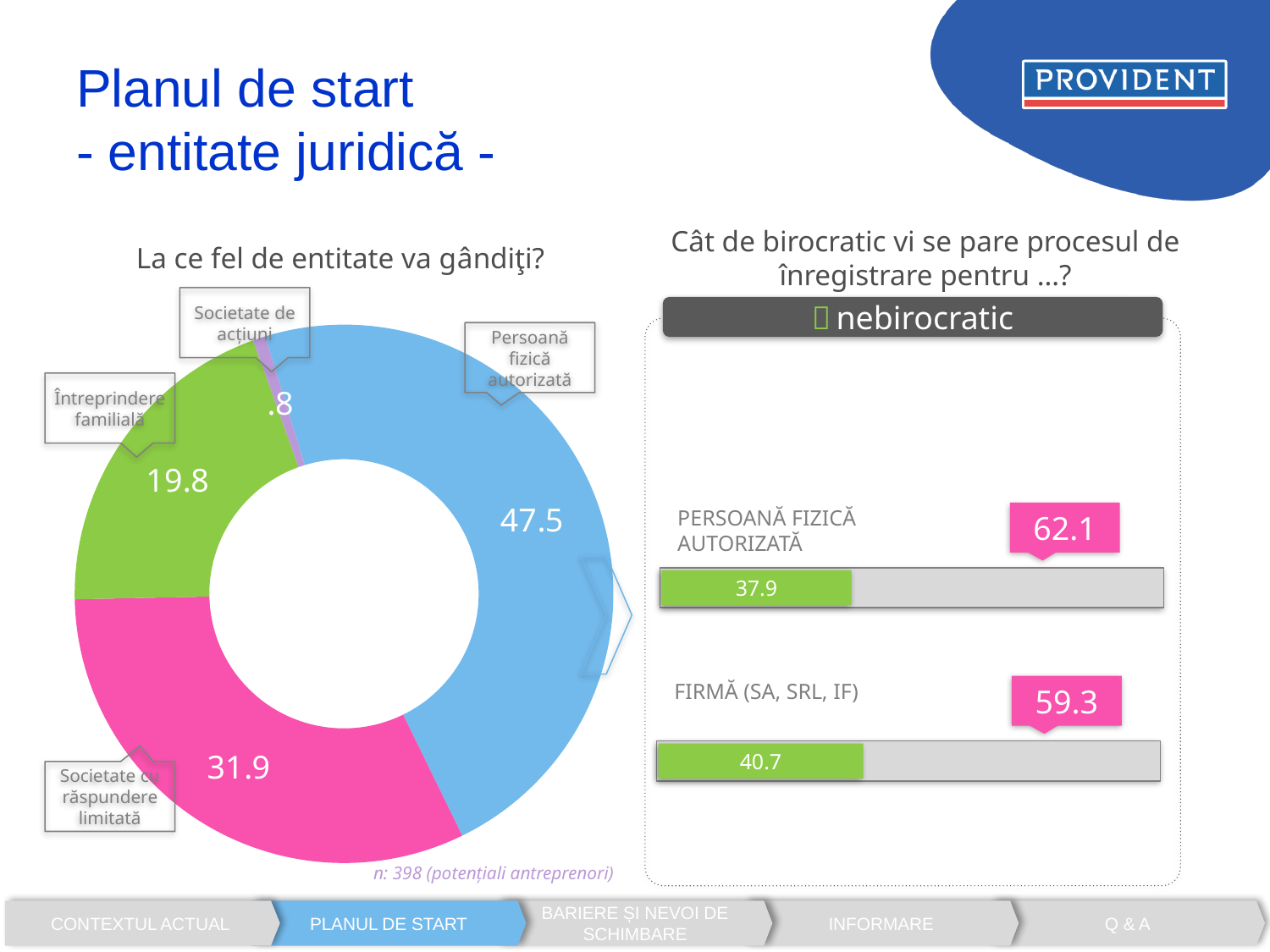
In the donut chart 'La ce fel de entitate va gândiţi?', what is the value for Societate cu răspundere limitată? 31.9 In the donut chart 'La ce fel de entitate va gândiţi?', what is the difference between the values for Persoană fizică autorizată and Societate cu răspundere limitată? 15.6 In the chart 'Cât de birocratic vi se pare procesul de înregistrare pentru ...?', what is the green 'nebirocratic' value for Persoană fizică autorizată? 37.9 In the donut chart 'La ce fel de entitate va gândiţi?', what is the value for Persoană fizică autorizată? 47.5 In the donut chart 'La ce fel de entitate va gândiţi?', how many categories are shown? 4 What kind of chart is the one on the left titled 'La ce fel de entitate va gândiţi?'? Donut (pie) chart In the chart 'Cât de birocratic vi se pare procesul de înregistrare pentru ...?', what is the green 'nebirocratic' value for Firmă (SA, SRL, IF)? 40.7 In the donut chart 'La ce fel de entitate va gândiţi?', what is the value for Întreprindere familială? 19.8 In the chart 'Cât de birocratic vi se pare procesul de înregistrare pentru ...?', what value is shown in the pink callout for Firmă (SA, SRL, IF)? 59.3 In the donut chart 'La ce fel de entitate va gândiţi?', which category has the smallest share? Societate de acțiuni In the chart 'Cât de birocratic vi se pare procesul de înregistrare pentru ...?', which has the larger green 'nebirocratic' value: Persoană fizică autorizată or Firmă (SA, SRL, IF)? Firmă (SA, SRL, IF) In the donut chart 'La ce fel de entitate va gândiţi?', which category has the largest share? Persoană fizică autorizată